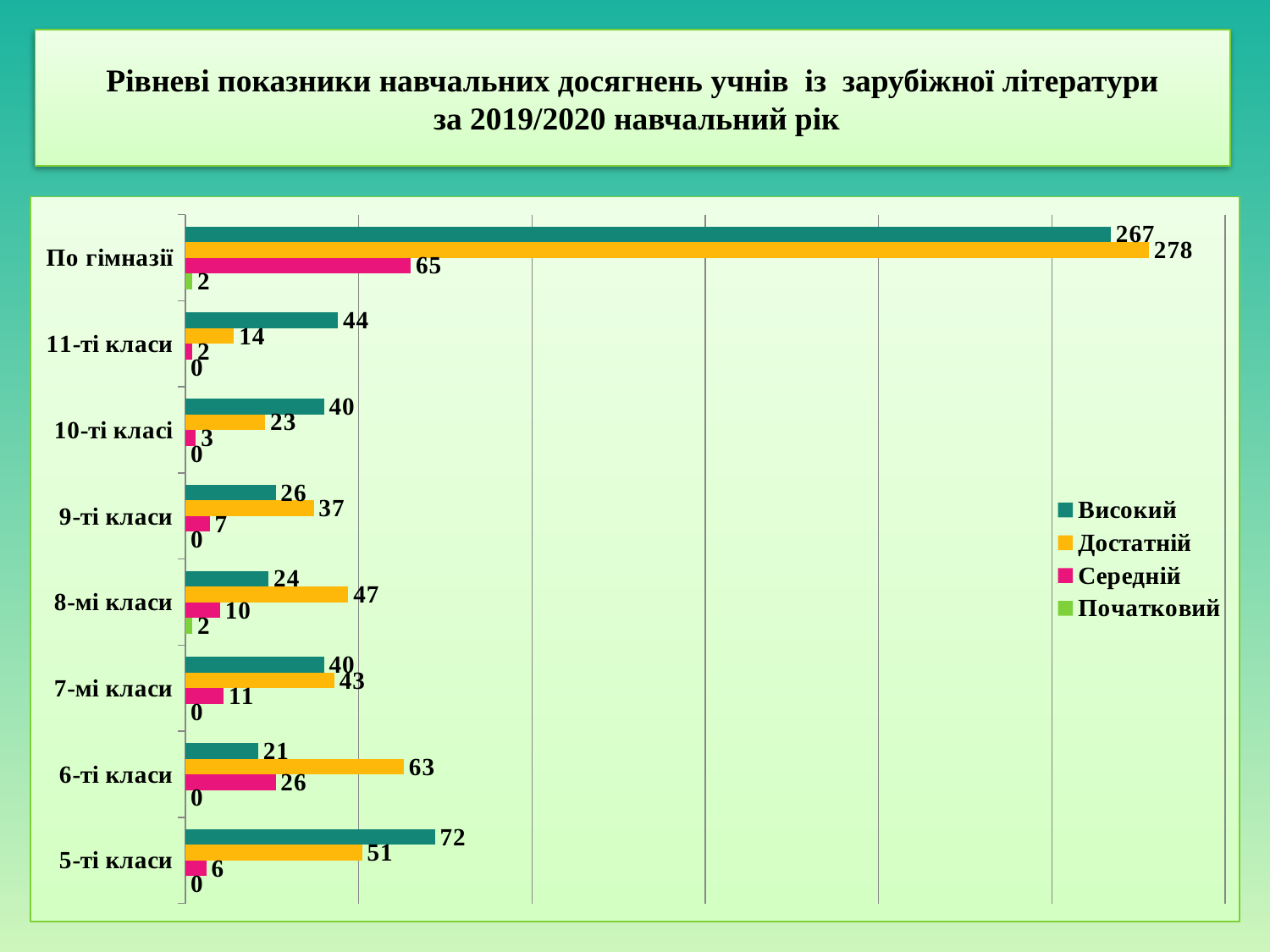
What kind of chart is shown on the slide? bar chart Among the class categories (excluding По гімназії), which has the lowest Достатній value? 11-ті класи What is the value of Високий for 5-ті класи? 72 What is the value of Середній for 6-ті класи? 26 How many categories are shown on the vertical axis? 8 Which is larger for 9-ті класи: Високий or Достатній? Достатній What is the value of Достатній for По гімназії? 278 What is the difference between the Достатній and Високий values for По гімназії? 11 What is the value of Початковий for 8-мі класи? 2 How many series does the legend list? 4 What is the total of the four series values for 7-мі класи? 94 Among the class categories (excluding По гімназії), which has the highest Високий value? 5-ті класи